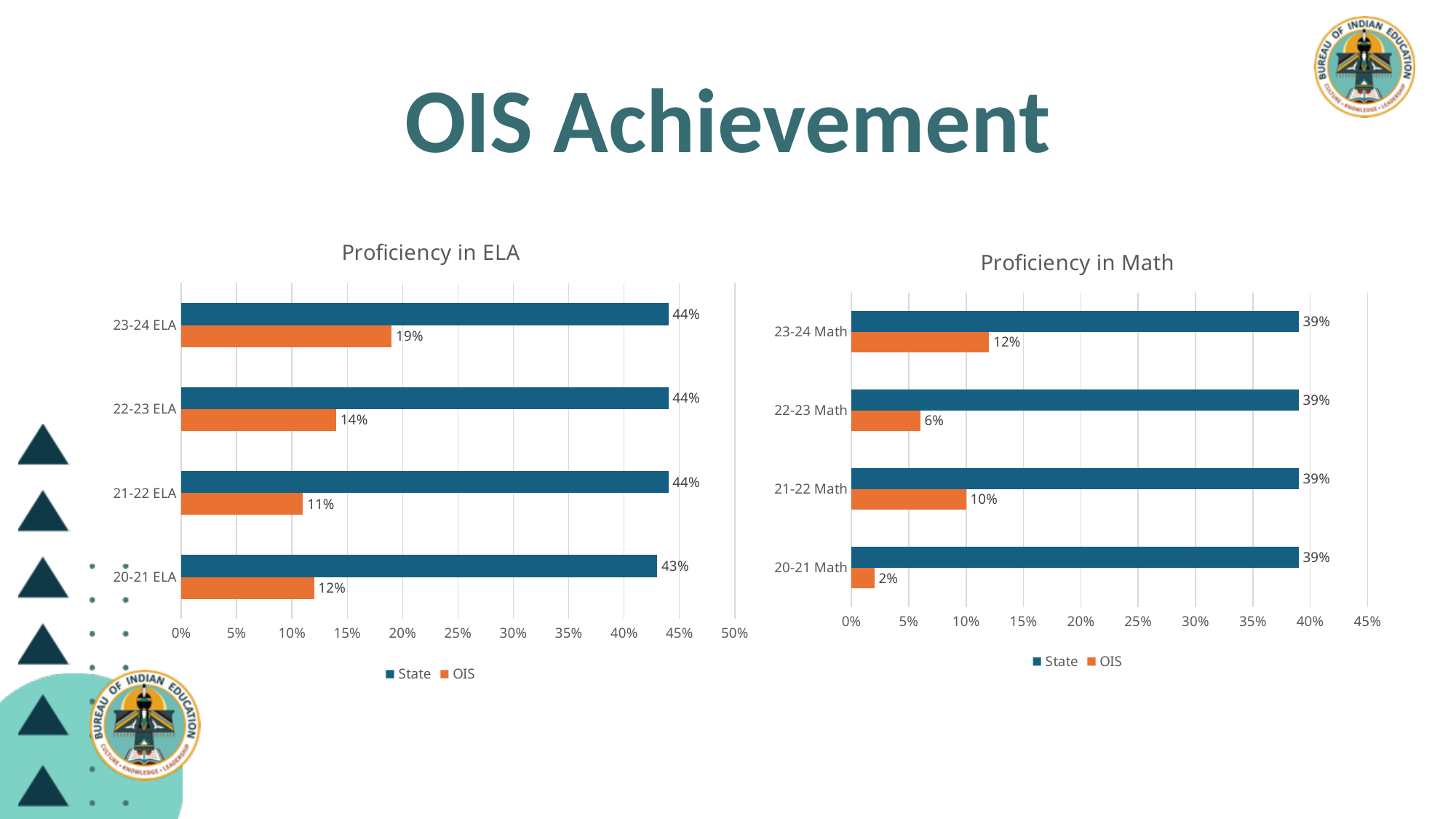
In the Proficiency in ELA chart, which category has the highest OIS value? 23-24 ELA In the Proficiency in Math chart, how many series does the legend list? 2 In the Proficiency in Math chart, what are the two legend entries? State and OIS In the Proficiency in ELA chart, what is the difference between the State and OIS values for 22-23 ELA? 30% In the Proficiency in Math chart, what is the State value for 22-23 Math? 39% In the Proficiency in Math chart, which category has the lowest OIS value? 20-21 Math In the Proficiency in ELA chart, what is the OIS value for 23-24 ELA? 19% What kind of chart is the Proficiency in ELA chart? Bar chart In the Proficiency in Math chart, what is the OIS value for 20-21 Math? 2% In the Proficiency in Math chart, which is larger, the OIS value for 21-22 Math or the OIS value for 22-23 Math? 21-22 Math In the Proficiency in ELA chart, what is the OIS value for 21-22 ELA? 11% In the Proficiency in ELA chart, how many categories are shown on the vertical axis? 4